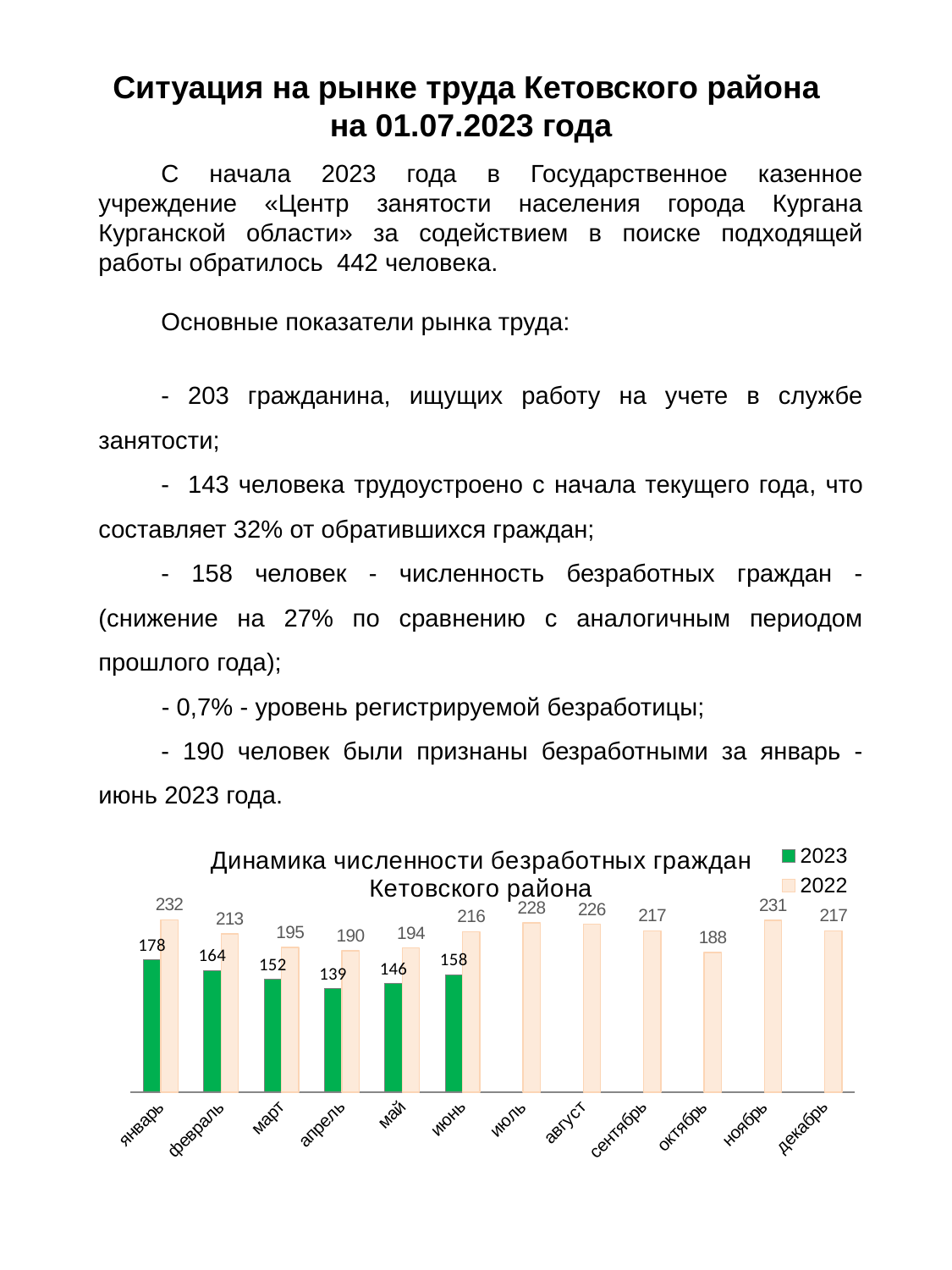
What is the difference between the 2022 and 2023 values in январь? 54 Which month has the lowest value for the 2023 series? апрель What is the value for 2022 in июнь? 216 What is the difference between the 2022 and 2023 values in июнь? 58 What kind of chart is shown on the slide? bar chart What is the value for 2022 in октябрь? 188 Which is larger in май: the 2022 value or the 2023 value? 2022 What is the title of the chart? Динамика численности безработных граждан Кетовского района How many series does the legend list? 2 What is the value for 2023 in январь? 178 Which month has the highest value for the 2022 series? январь How many months have a value plotted for the 2023 series? 6